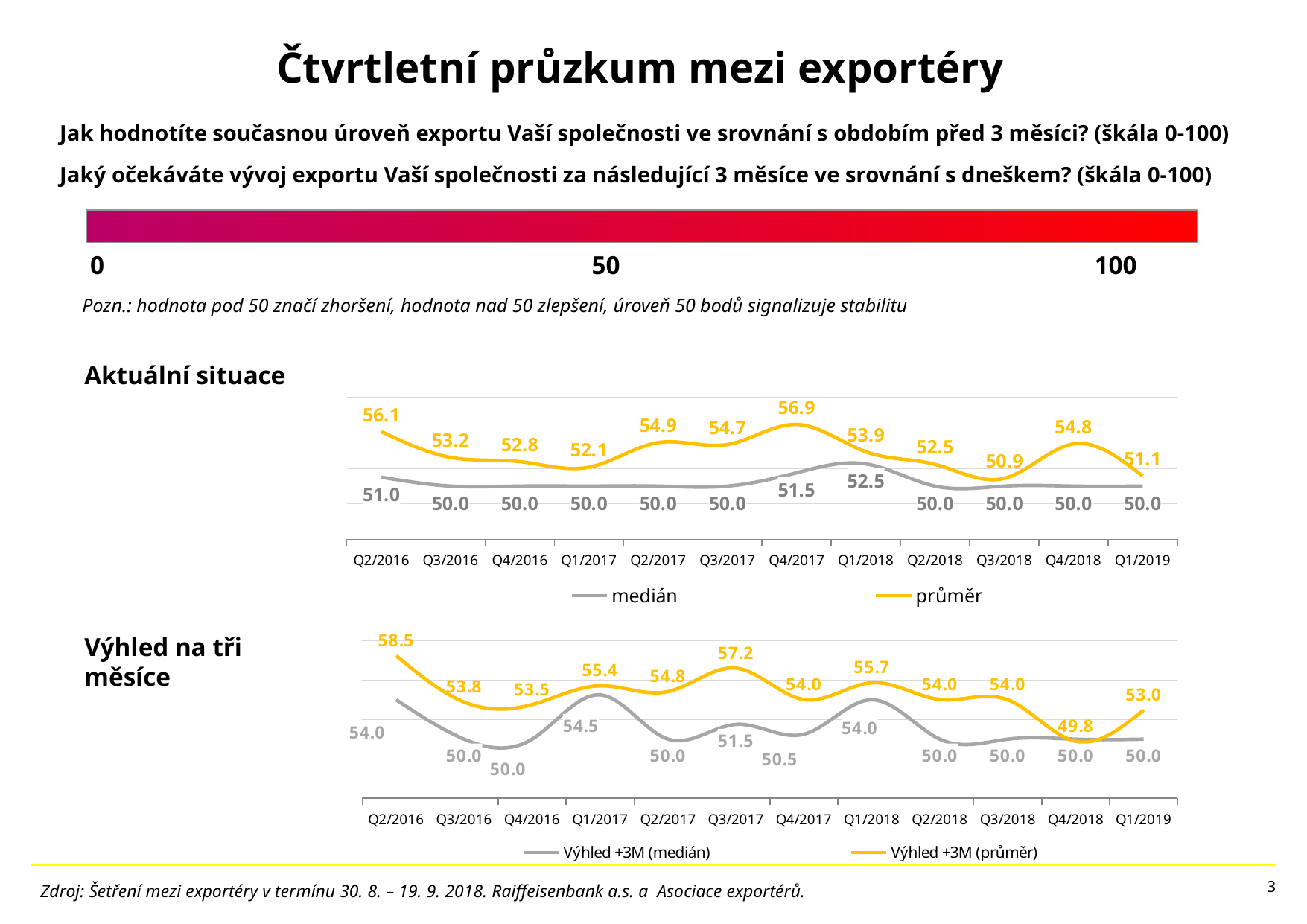
In the 'Výhled na tři měsíce' chart, what is the Výhled +3M (průměr) value for Q3/2017? 57.2 In the 'Aktuální situace' chart, what is the medián value for Q1/2018? 52.5 In the 'Aktuální situace' chart, what is the průměr value for Q4/2017? 56.9 In the 'Aktuální situace' chart, which quarter has the lowest průměr value? Q3/2018 How many series does the legend of the 'Výhled na tři měsíce' chart list? 2 What type of chart is the 'Aktuální situace' chart? Line chart In the 'Aktuální situace' chart, which quarter has the highest průměr value? Q4/2017 In the 'Výhled na tři měsíce' chart, what is the Výhled +3M (medián) value for Q1/2017? 54.5 How many quarters are plotted on the x axis of the 'Aktuální situace' chart? 12 In the 'Výhled na tři měsíce' chart, which is larger: the Výhled +3M (průměr) value for Q2/2016 or for Q1/2019? Q2/2016 In the 'Výhled na tři měsíce' chart, which quarter has the lowest Výhled +3M (průměr) value? Q4/2018 In the 'Aktuální situace' chart, what is the difference between the průměr values for Q2/2016 and Q1/2019? 5.0